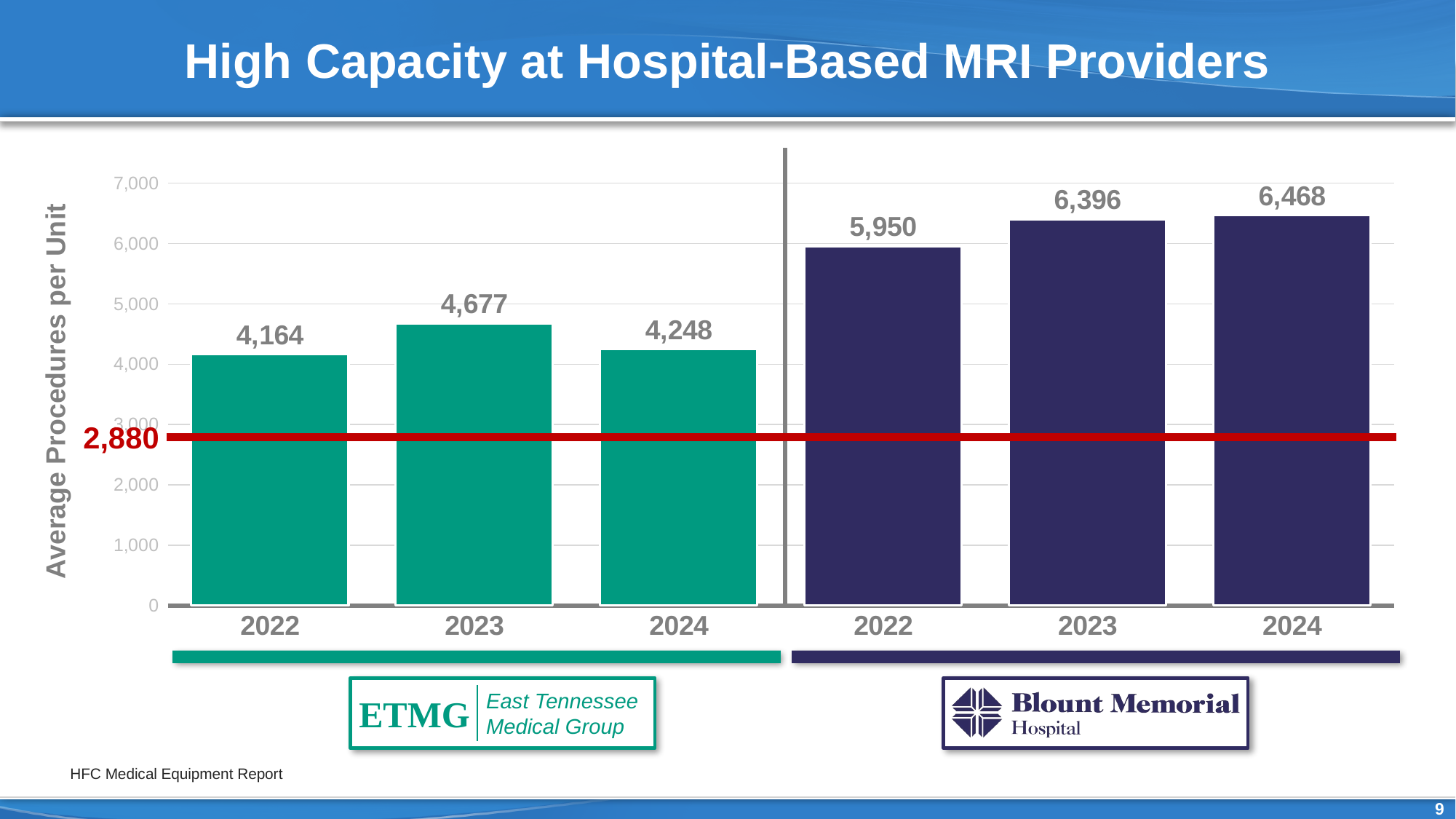
Is the value for East Tennessee Medical Group in 2022 greater or less than 4,000? greater How many bars are plotted on the chart in total? 6 Which is larger: East Tennessee Medical Group's 2024 value or its 2022 value? 2024 (4,248) What is the average procedures per unit for Blount Memorial Hospital in 2024? 6,468 What is the average procedures per unit for East Tennessee Medical Group in 2023? 4,677 What kind of chart is shown on the slide? Bar chart What is the value for Blount Memorial Hospital in 2022? 5,950 Do the values for Blount Memorial Hospital rise or fall from 2022 to 2024? Rise Which year has the highest value for Blount Memorial Hospital? 2024 What is the difference between Blount Memorial Hospital's 2023 value and East Tennessee Medical Group's 2023 value? 1,719 Which year has the lowest value for East Tennessee Medical Group? 2022 What value is marked by the red horizontal line on the chart? 2,880